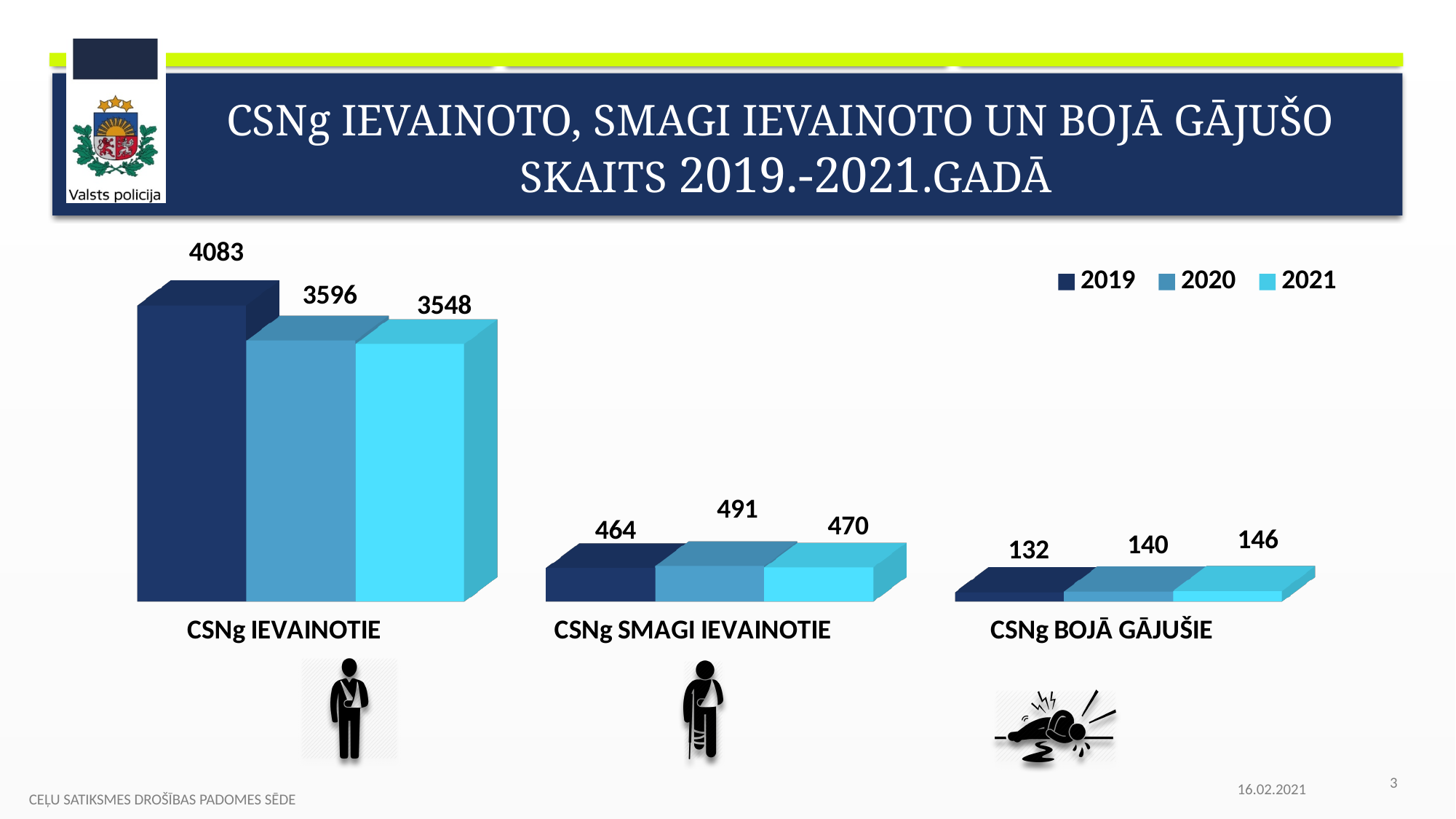
Which year has the lowest value in the CSNg BOJĀ GĀJUŠIE category? 2019 What is the value for 2021 in the CSNg SMAGI IEVAINOTIE category? 470 Which year has the highest value in the CSNg SMAGI IEVAINOTIE category? 2020 How many categories are shown on the x axis? 3 What is the difference between the 2019 and 2021 values in the CSNg IEVAINOTIE category? 535 How many series does the legend list? 3 What is the value for 2020 in the CSNg BOJĀ GĀJUŠIE category? 140 What is the difference between the 2021 and 2019 values in the CSNg BOJĀ GĀJUŠIE category? 14 What is the value for 2019 in the CSNg IEVAINOTIE category? 4083 Do the values for the CSNg BOJĀ GĀJUŠIE category rise or fall from 2019 to 2021? rise Which is larger: the 2020 value or the 2021 value in the CSNg IEVAINOTIE category? 2020 What kind of chart is shown on the slide? bar chart